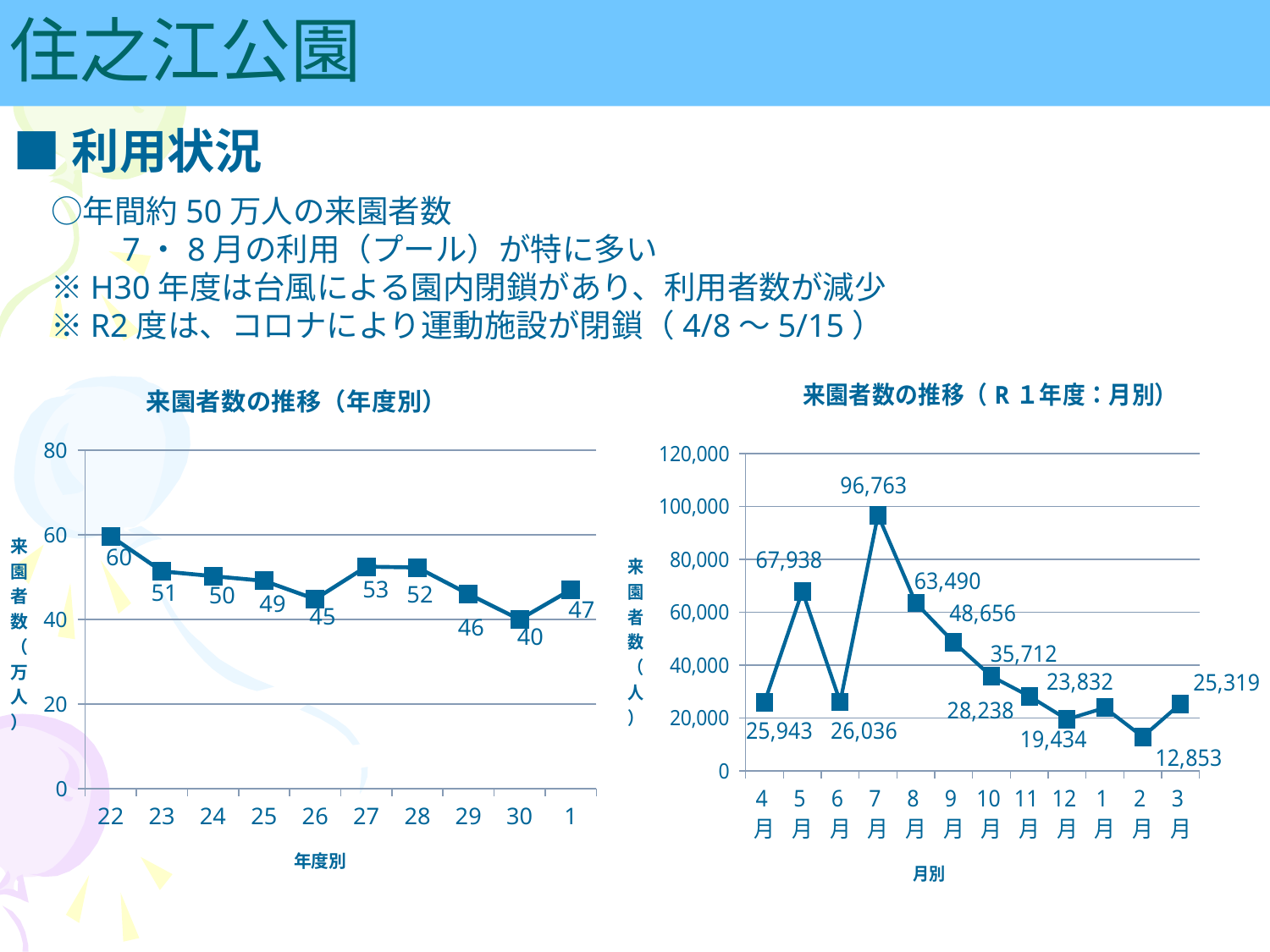
In the chart titled 来園者数の推移（R１年度：月別）, what is the value for 2月? 12,853 What kind of chart is the chart titled 来園者数の推移（年度別）? line chart In the chart titled 来園者数の推移（年度別）, which year has the lowest value? 30 In the chart titled 来園者数の推移（R１年度：月別）, what is the value for 7月? 96,763 In the chart titled 来園者数の推移（R１年度：月別）, which month has the highest value? 7月 In the chart titled 来園者数の推移（年度別）, what is the value for year 22? 60 In the chart titled 来園者数の推移（R１年度：月別）, which is larger, the value for 5月 or the value for 8月? 5月 In the chart titled 来園者数の推移（R１年度：月別）, what is the difference between the values for 7月 and 8月? 33,273 In the chart titled 来園者数の推移（年度別）, what is the difference between the values for year 27 and year 26? 8 In the chart titled 来園者数の推移（年度別）, how many years are plotted? 10 In the chart titled 来園者数の推移（年度別）, which year has the highest value? 22 In the chart titled 来園者数の推移（年度別）, what is the value for year 30? 40